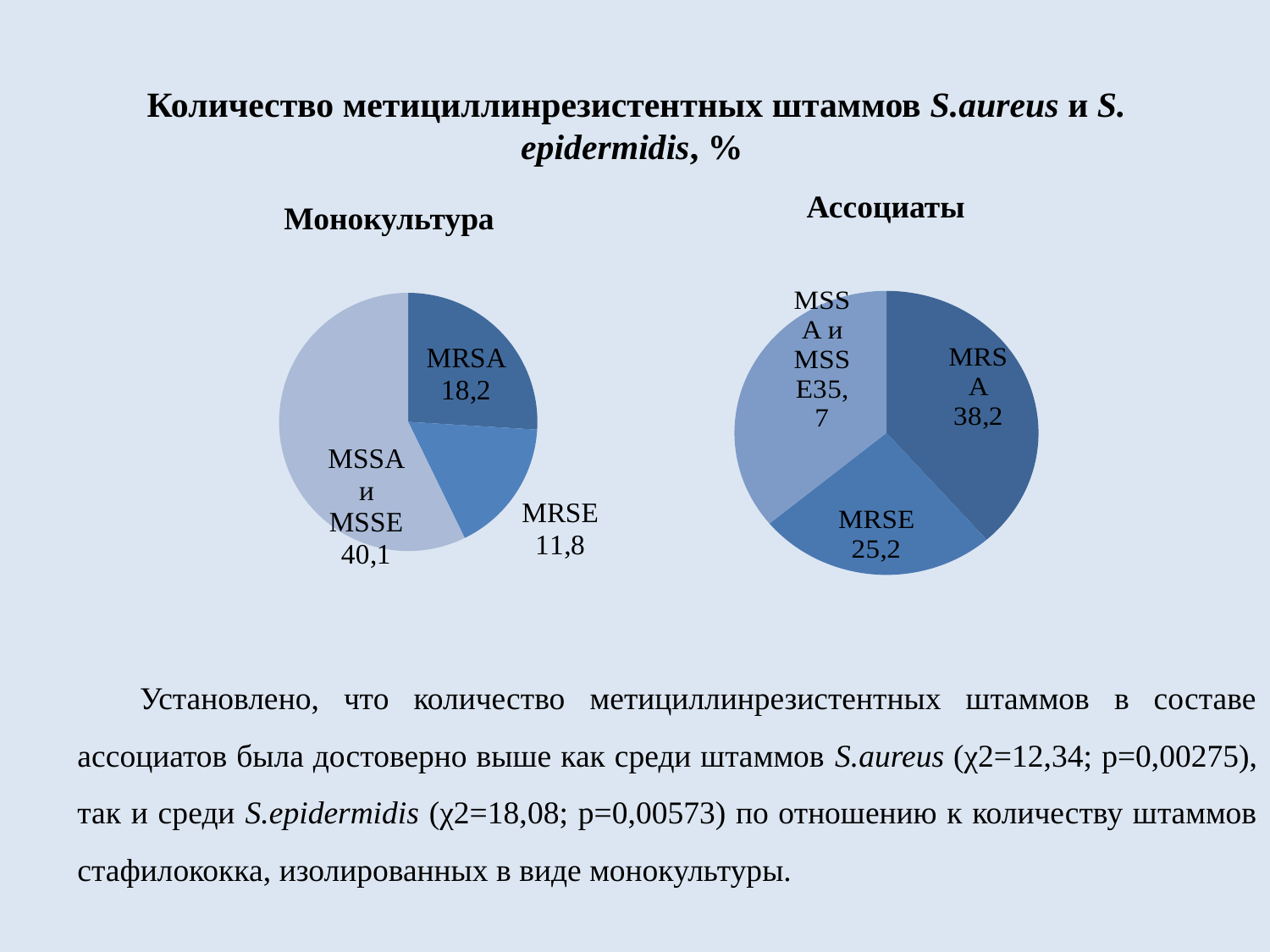
In the 'Монокультура' chart, which category has the smallest slice? MRSE In the 'Монокультура' chart, what is the value for MRSE? 11,8 In the 'Монокультура' chart, what is the value for MRSA? 18,2 In the 'Ассоциаты' chart, what is the difference between MRSA and MRSE? 13 How many slices does the 'Монокультура' chart have? 3 In the 'Ассоциаты' chart, what is the value for MRSA? 38,2 In the 'Ассоциаты' chart, which category has the smallest slice? MRSE Which is larger: MRSE in the 'Монокультура' chart or MRSE in the 'Ассоциаты' chart? MRSE in the 'Ассоциаты' chart What is the difference between the MRSA values in the 'Ассоциаты' chart and the 'Монокультура' chart? 20 In the 'Монокультура' chart, which category has the largest slice? MSSA и MSSE In the 'Ассоциаты' chart, what is the value for MSSA и MSSE? 35,7 What type of chart is the 'Ассоциаты' chart? Pie chart